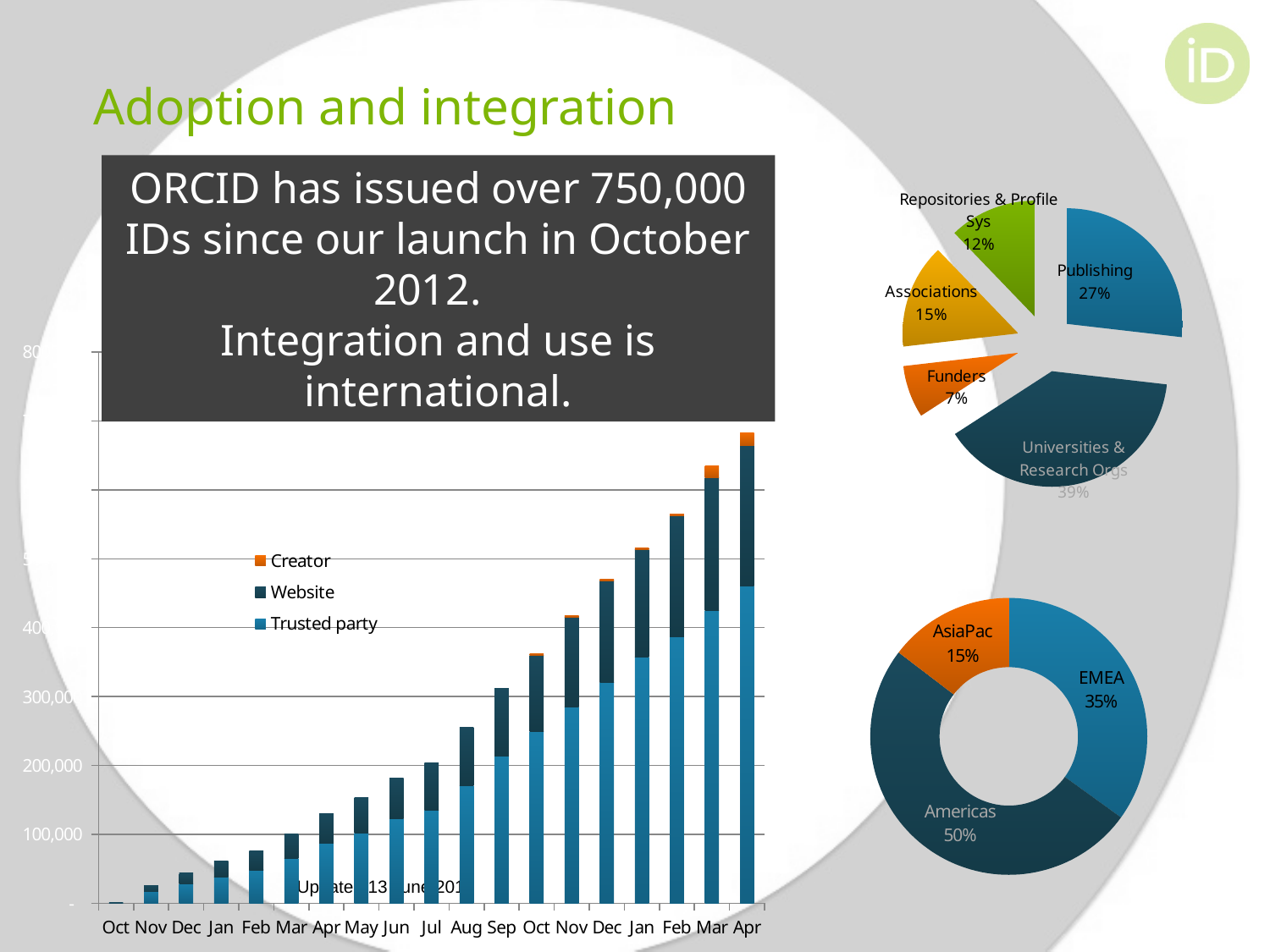
In the pie chart at the top right, what share does Publishing have? 27% In the pie chart at the top right, how many sectors are shown? 5 In the doughnut chart at the bottom right, what share does Americas have? 50% In the bar chart on the left, is the total for the final Apr bar greater or less than 500,000? greater In the bar chart on the left, do the bar totals rise or fall from Oct to the final Apr? Rise In the doughnut chart at the bottom right, how many regions are shown? 3 In the pie chart at the top right, which sector has the largest share? Universities & Research Orgs In the pie chart at the top right, how many percentage points larger is Publishing than Funders? 20 percentage points In the pie chart at the top right, which sector has the smallest share? Funders In the bar chart on the left, how many series does the legend list? 3 What kind of chart is the chart on the left of the slide? Stacked bar chart In the doughnut chart at the bottom right, which is larger, EMEA or AsiaPac? EMEA